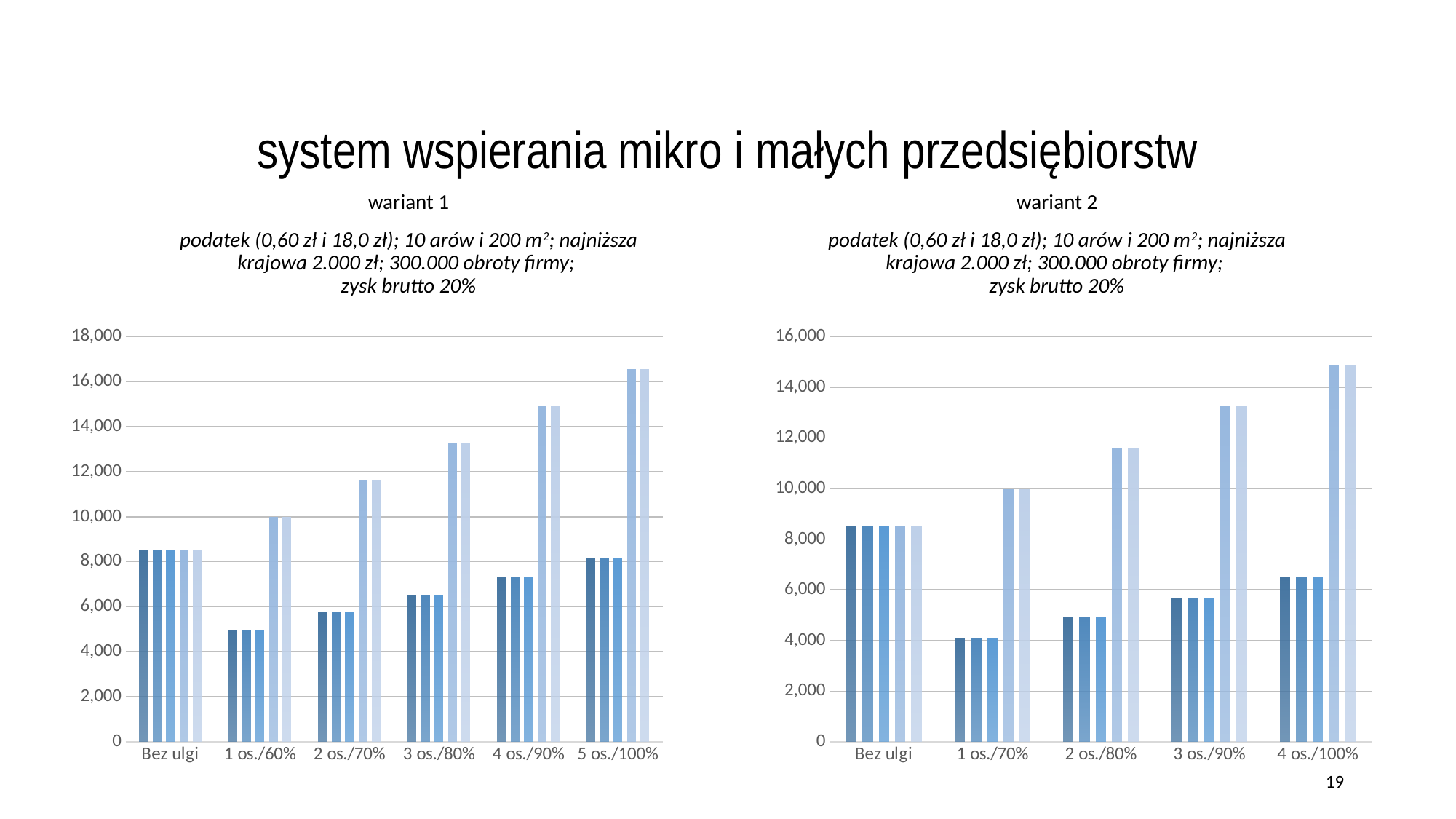
In the 'wariant 2' chart, are the dark blue bars for '1 os./70%' greater or less than 6,000? less How many categories are shown on the x axis of the 'wariant 2' chart? 5 In the 'wariant 2' chart, which category has the lowest dark blue bars? 1 os./70% In the 'wariant 1' chart, how many bars are plotted for each category? 5 What is the title of the slide? system wspierania mikro i małych przedsiębiorstw What kind of chart is the 'wariant 1' chart on the left? bar chart In the 'wariant 1' chart, are the tallest bars for '5 os./100%' greater or less than 16,000? greater How many categories are shown on the x axis of the 'wariant 1' chart? 6 In the 'wariant 1' chart, which category has the tallest bars? 5 os./100% In the 'wariant 1' chart, are the dark blue bars for '1 os./60%' greater or less than 6,000? less